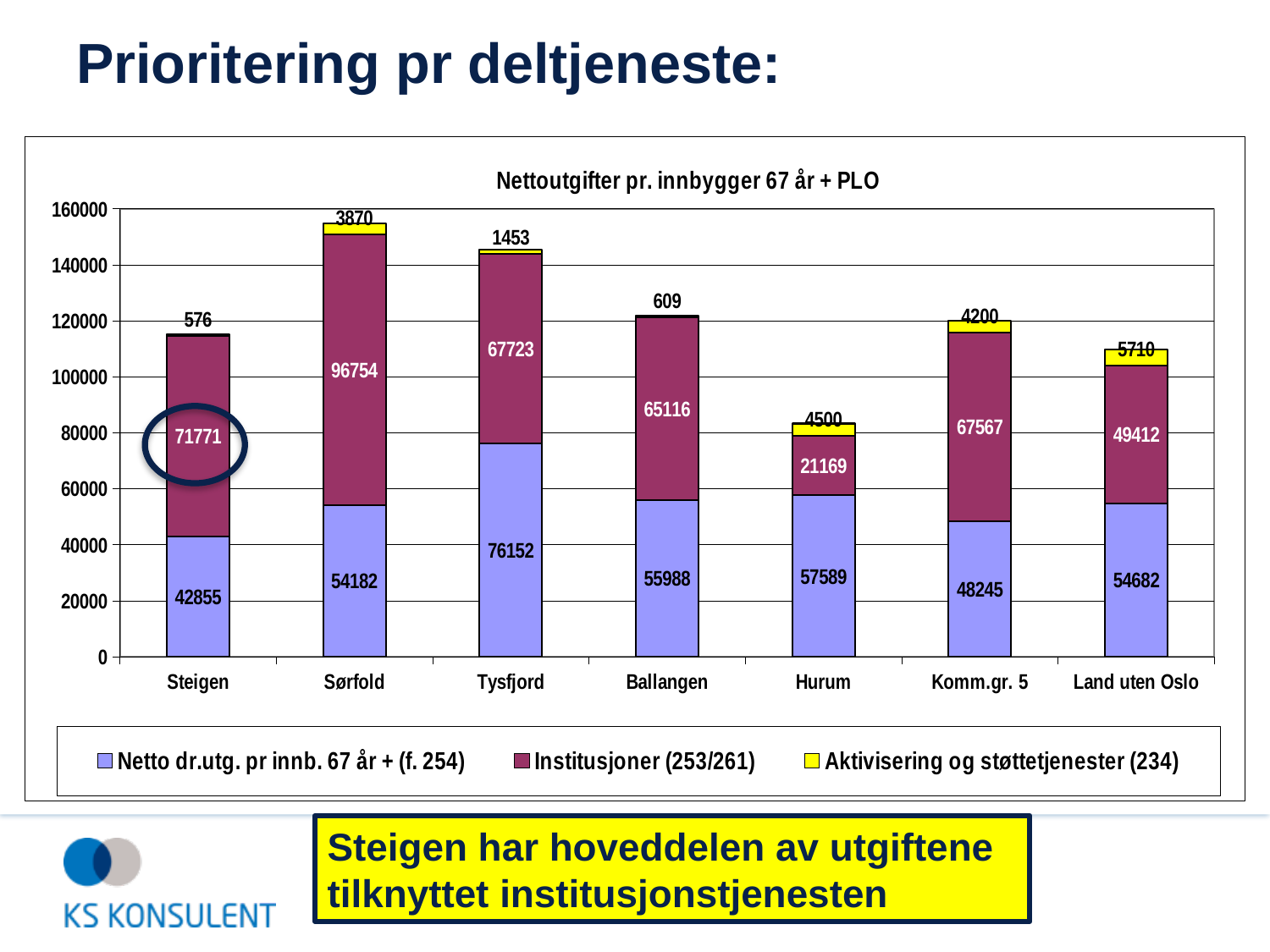
What type of chart is shown on the slide? Stacked bar chart What is the value of Institusjoner (253/261) for Steigen? 71771 What is the total of the stacked bar for Steigen? 115202 What is the value of Netto dr.utg. pr innb. 67 år + (f. 254) for Tysfjord? 76152 Which category has the highest value for Institusjoner (253/261)? Sørfold Which is larger: the Netto dr.utg. pr innb. 67 år + (f. 254) value for Hurum or for Komm.gr. 5? Hurum How many categories are shown on the x axis? 7 Which category has the lowest value for Institusjoner (253/261)? Hurum How many series does the legend list? 3 Is the total stacked bar for Hurum greater or less than 100000? less What is the value of Aktivisering og støttetjenester (234) for Land uten Oslo? 5710 What is the difference between the Institusjoner (253/261) values for Sørfold and Steigen? 24983